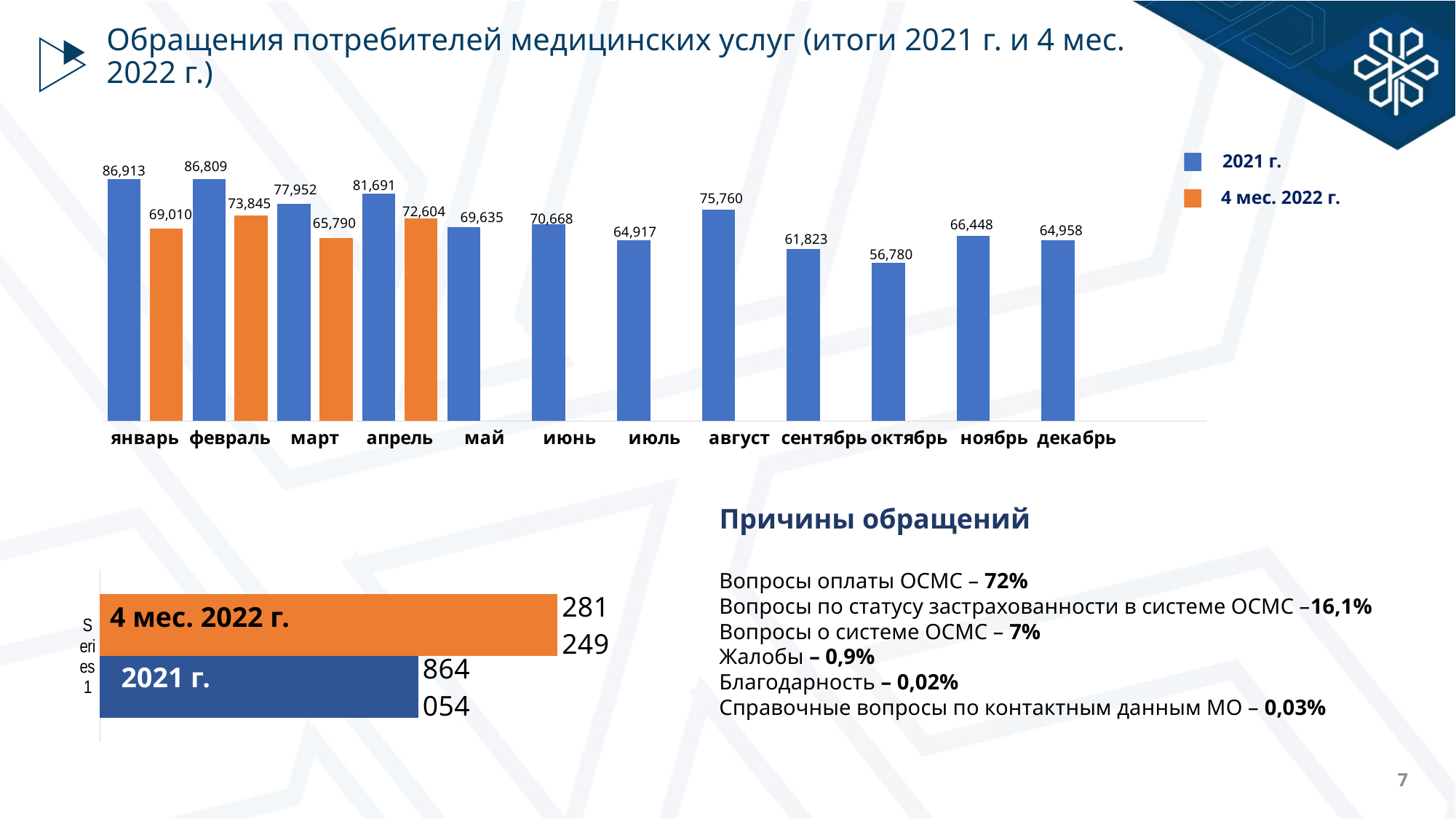
In the top chart, do the 2021 г. values rise or fall from август to октябрь? fall In the top chart, what is the value for январь in the 2021 г. series? 86,913 In the top chart, which month has the lowest value in the 2021 г. series? октябрь In the top chart, what is the difference between the 2021 г. and 4 мес. 2022 г. values for март? 12,162 In the top chart, which month has the highest value in the 4 мес. 2022 г. series? февраль In the top chart, what is the difference between the 2021 г. and 4 мес. 2022 г. values for январь? 17,903 In the top chart, how many months are shown on the x axis? 12 In the top chart, which is larger in the 2021 г. series: август or июнь? август In the top chart, what is the value for апрель in the 4 мес. 2022 г. series? 72,604 How many series does the legend of the top chart list? 2 In the top chart, what is the value for октябрь in the 2021 г. series? 56,780 What kind of chart is the top chart? bar chart